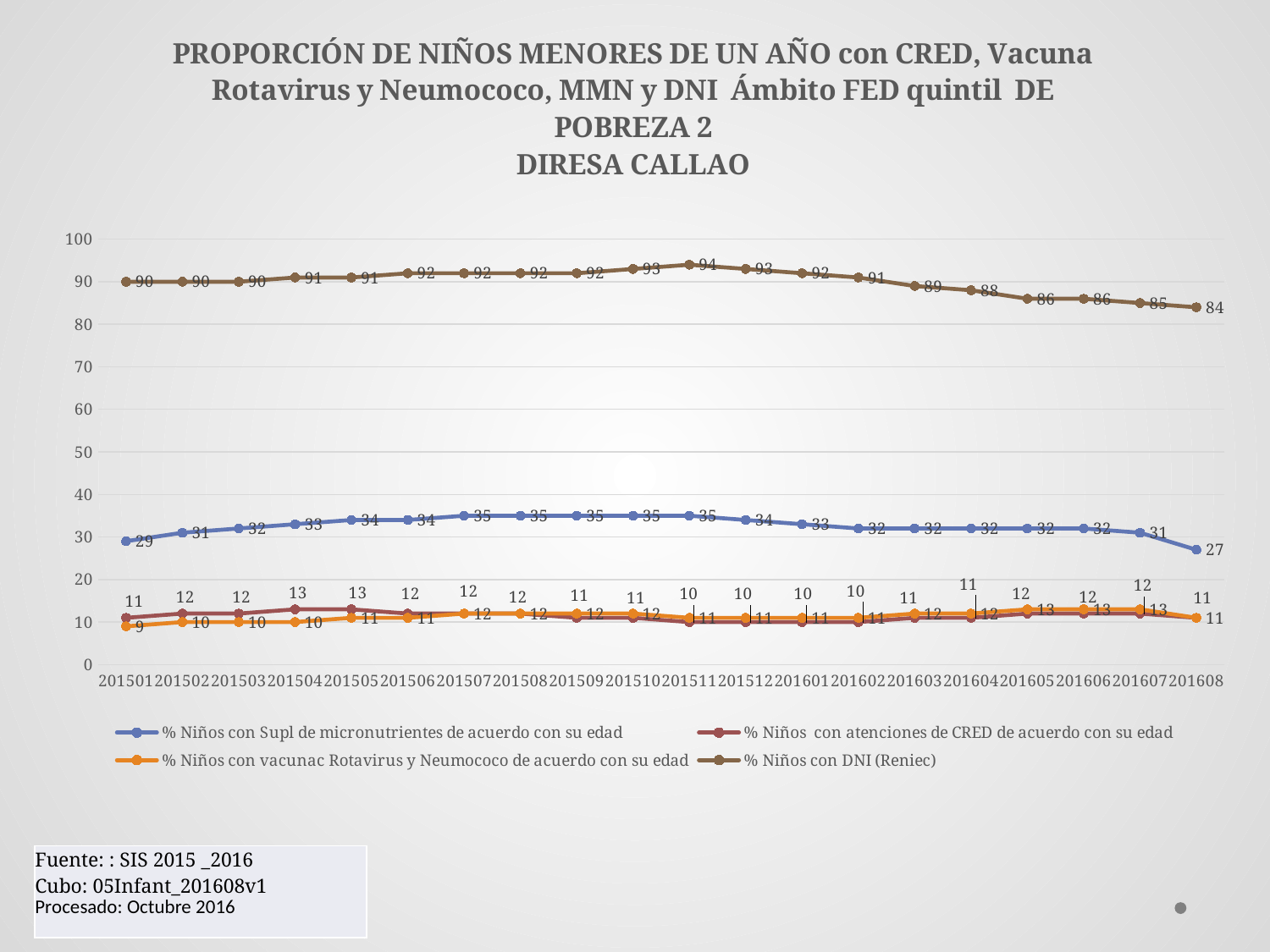
In 201501, which is larger: % Niños con DNI (Reniec) or % Niños con Supl de micronutrientes de acuerdo con su edad? % Niños con DNI (Reniec) In which period is % Niños con Supl de micronutrientes de acuerdo con su edad at its lowest? 201608 How many time periods are plotted along the x axis? 20 How many series does the legend list? 4 What is the difference between the % Niños con DNI (Reniec) value in 201501 and in 201608? 6 What is the value for % Niños con DNI (Reniec) in 201511? 94 In which period does % Niños con DNI (Reniec) reach its highest value? 201511 What kind of chart is shown on the slide? line chart Is the value for % Niños con DNI (Reniec) in 201608 greater or less than 80? greater What is the value for % Niños con vacunac Rotavirus y Neumococo de acuerdo con su edad in 201501? 9 What is the value for % Niños con Supl de micronutrientes de acuerdo con su edad in 201608? 27 Does % Niños con DNI (Reniec) rise or fall from 201511 to 201608? fall